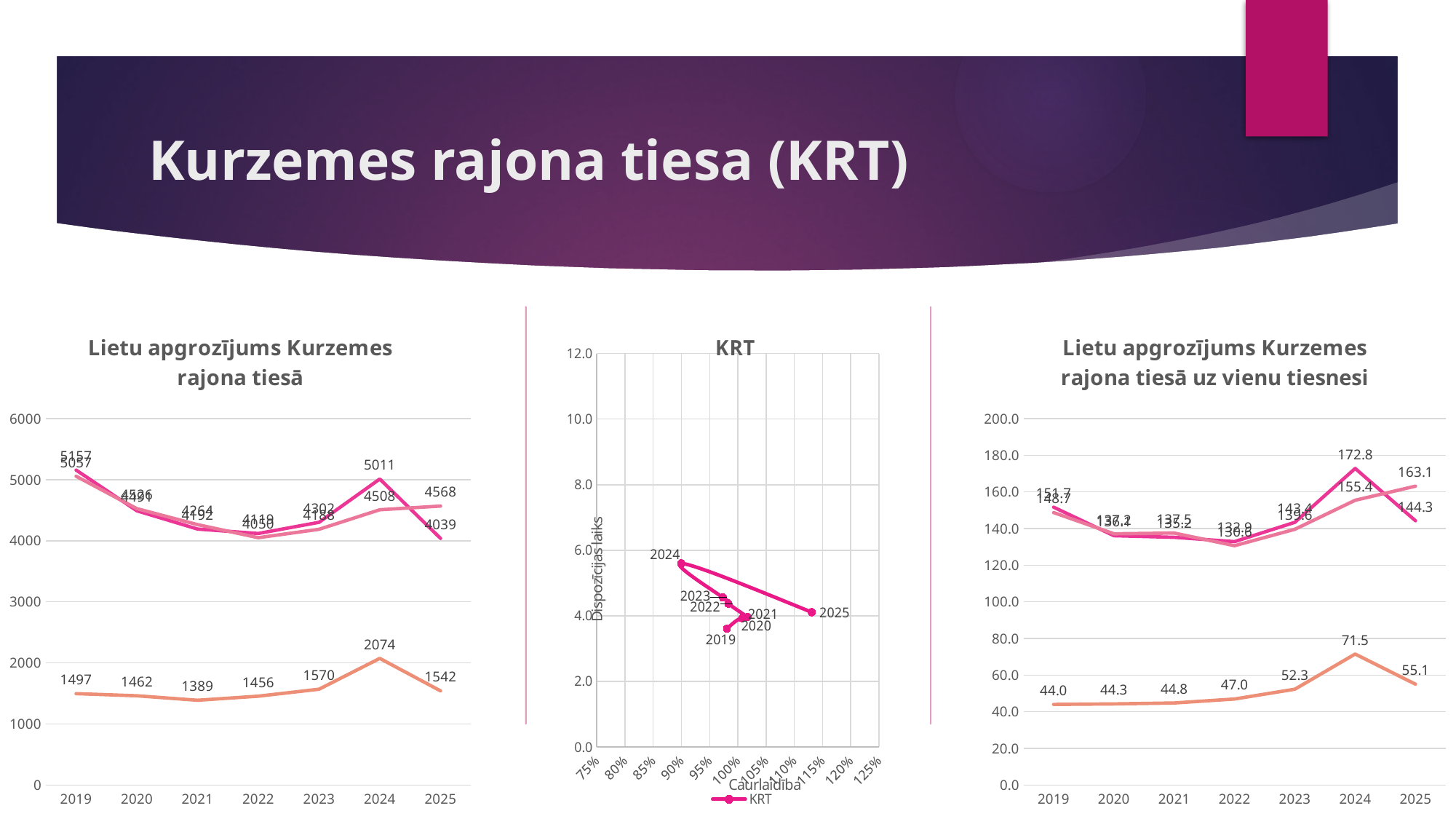
In the chart 'Lietu apgrozījums Kurzemes rajona tiesā', in which year does the lowest (orange) line reach its minimum? 2021 How many series does the legend of the 'KRT' chart list? 1 What kind of chart is the middle chart titled 'KRT'? scatter chart In the chart 'Lietu apgrozījums Kurzemes rajona tiesā uz vienu tiesnesi', what is the value of the orange line in 2024? 71.5 In the chart 'Lietu apgrozījums Kurzemes rajona tiesā', what is the difference between the orange line's 2024 value and its 2025 value? 532 In the chart 'Lietu apgrozījums Kurzemes rajona tiesā uz vienu tiesnesi', what is the highest value labelled on the chart? 172.8 In the 'KRT' chart, is the Caurlaidība value for 2025 greater or less than 110%? greater In the chart 'Lietu apgrozījums Kurzemes rajona tiesā', what is the value of the lowest (orange) line in 2024? 2074 In the chart 'Lietu apgrozījums Kurzemes rajona tiesā', what is the highest value labelled in 2019? 5157 How many years are shown on the x axis of the chart 'Lietu apgrozījums Kurzemes rajona tiesā'? 7 In the 'KRT' chart, is the Dispozīcijas laiks value for 2024 greater or less than 6.0? less In the chart 'Lietu apgrozījums Kurzemes rajona tiesā uz vienu tiesnesi', does the orange line rise or fall from 2019 to 2024? rise